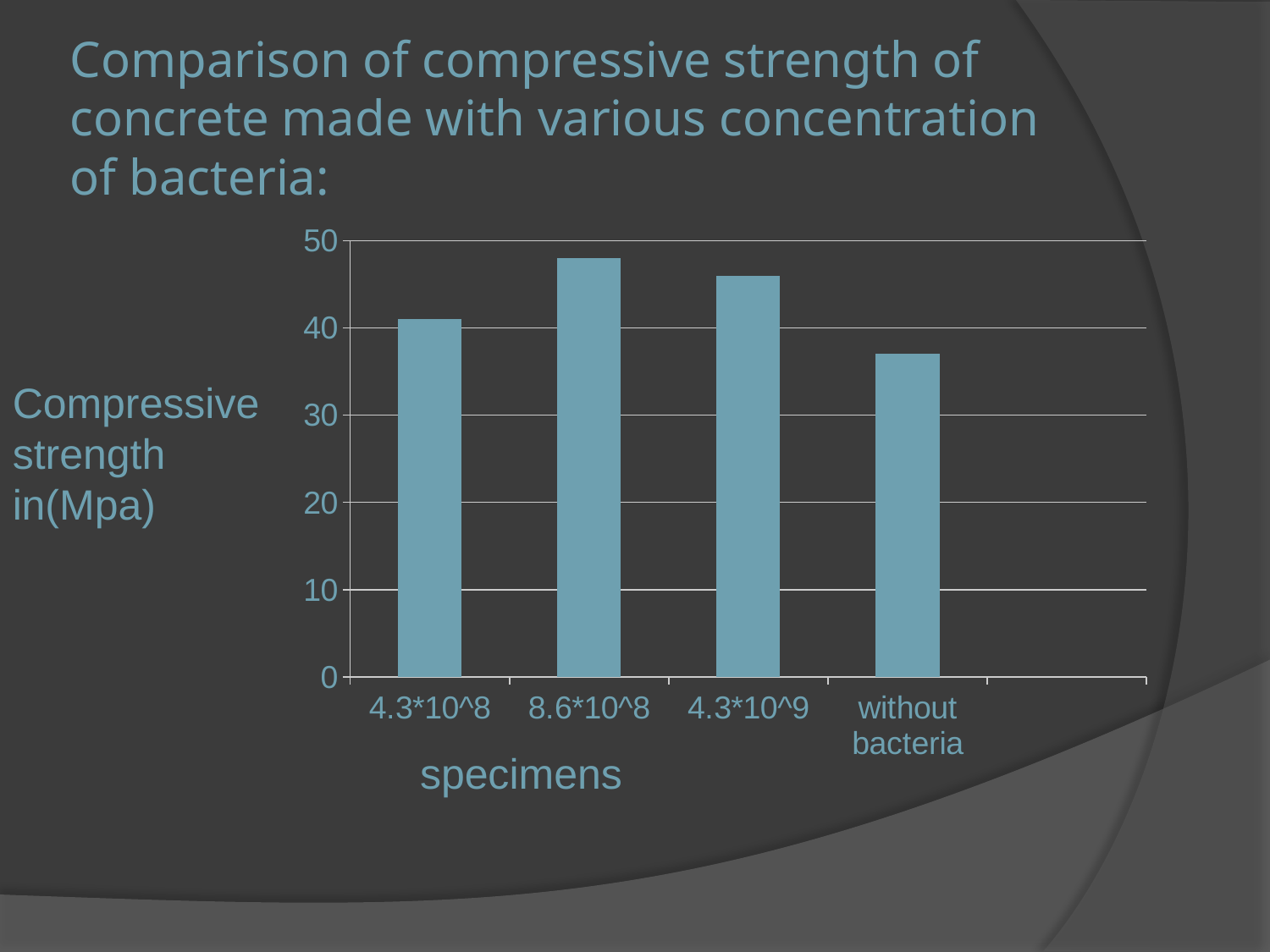
Is the value for 4.3*10^9 greater or less than 40? greater Do the values rise or fall from 8.6*10^8 to without bacteria along the x axis? fall Which is larger, the value for 8.6*10^8 or the value for 4.3*10^8? 8.6*10^8 Is the value for 4.3*10^8 greater or less than 30? greater Which specimen has the lowest compressive strength? without bacteria What kind of chart is shown on the slide? bar chart Is the value for without bacteria greater or less than 40? less How many specimen categories are plotted on the x axis? 4 Which specimen has the highest compressive strength? 8.6*10^8 What is the title of the x axis? specimens Which is larger, the value for 4.3*10^9 or the value for without bacteria? 4.3*10^9